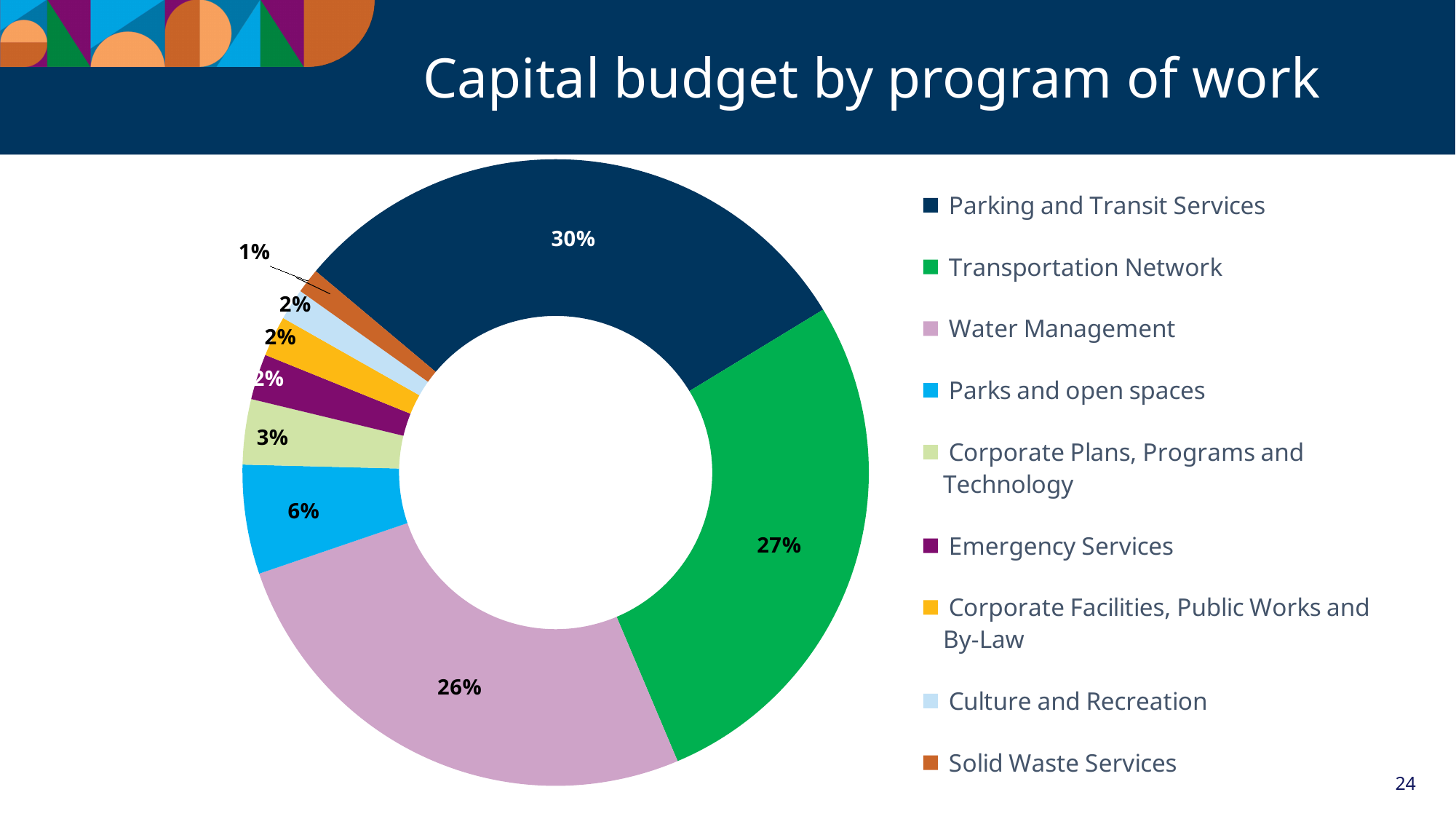
Which program of work has the smallest share of the capital budget? Solid Waste Services What is the share for Parks and open spaces? 6% Which has a larger share: Parks and open spaces or Corporate Plans, Programs and Technology? Parks and open spaces What is the difference in percentage points between Transportation Network and Water Management? 1 percentage point What is the title of the slide? Capital budget by program of work What type of chart is used on this slide? Pie chart (donut) Which program of work has the largest share of the capital budget? Parking and Transit Services What is the combined share of Parking and Transit Services and Transportation Network? 57% What percentage is shown for Solid Waste Services? 1% What share of the capital budget goes to Parking and Transit Services? 30% How many programs of work are shown in the chart? 9 What percentage of the capital budget is allocated to Water Management? 26%